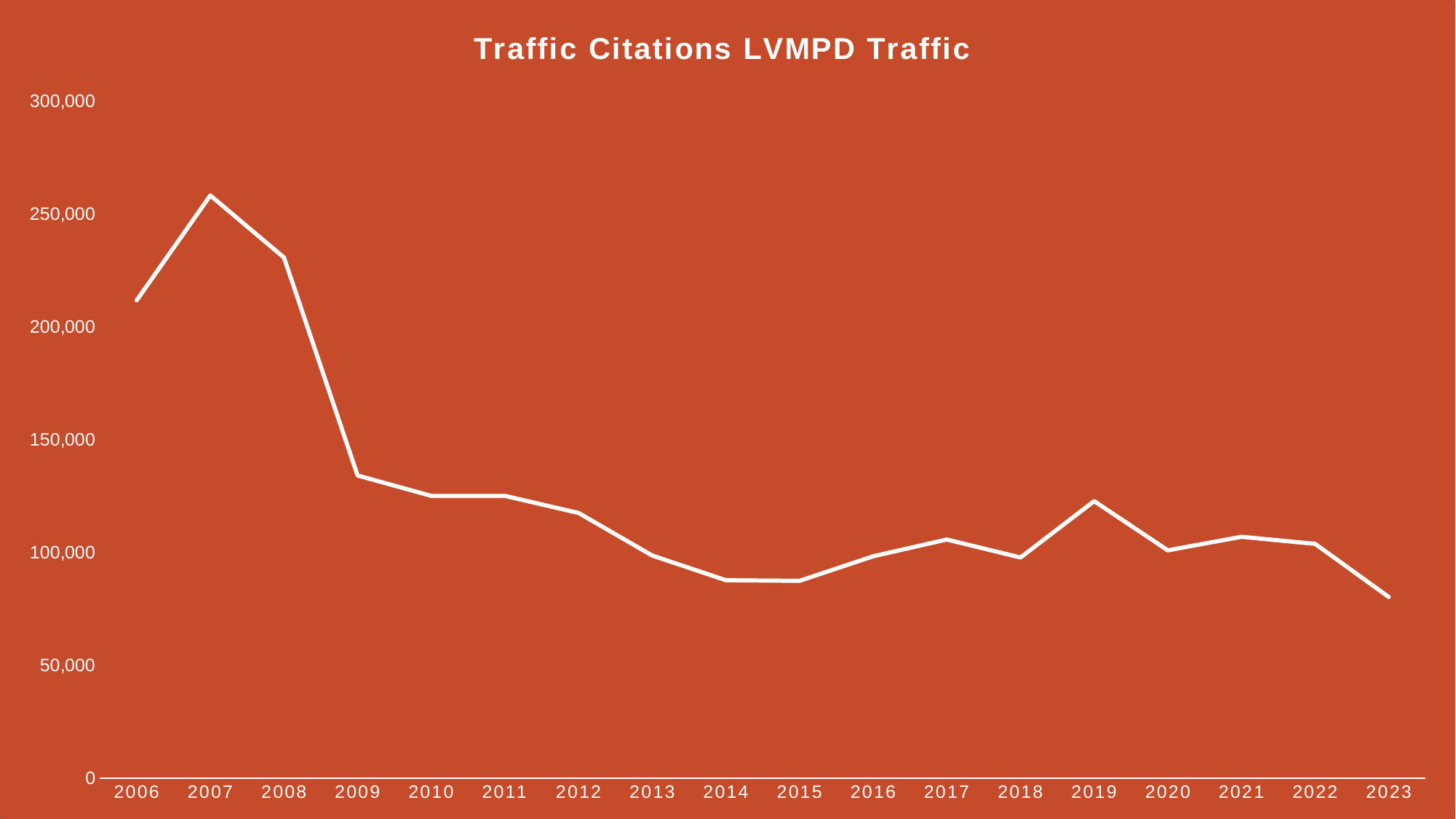
What is the title of the chart? Traffic Citations LVMPD Traffic Is the value for 2023 greater or less than 100,000? less How many years are plotted along the x axis? 18 Is the value for 2006 greater or less than 200,000? greater Which year has the lowest number of traffic citations? 2023 Is the value for 2007 greater or less than 250,000? greater Which year has the highest number of traffic citations? 2007 Do the values generally rise or fall from 2007 to 2009? fall Which year has a higher value, 2007 or 2008? 2007 What kind of chart is shown on the slide? line chart